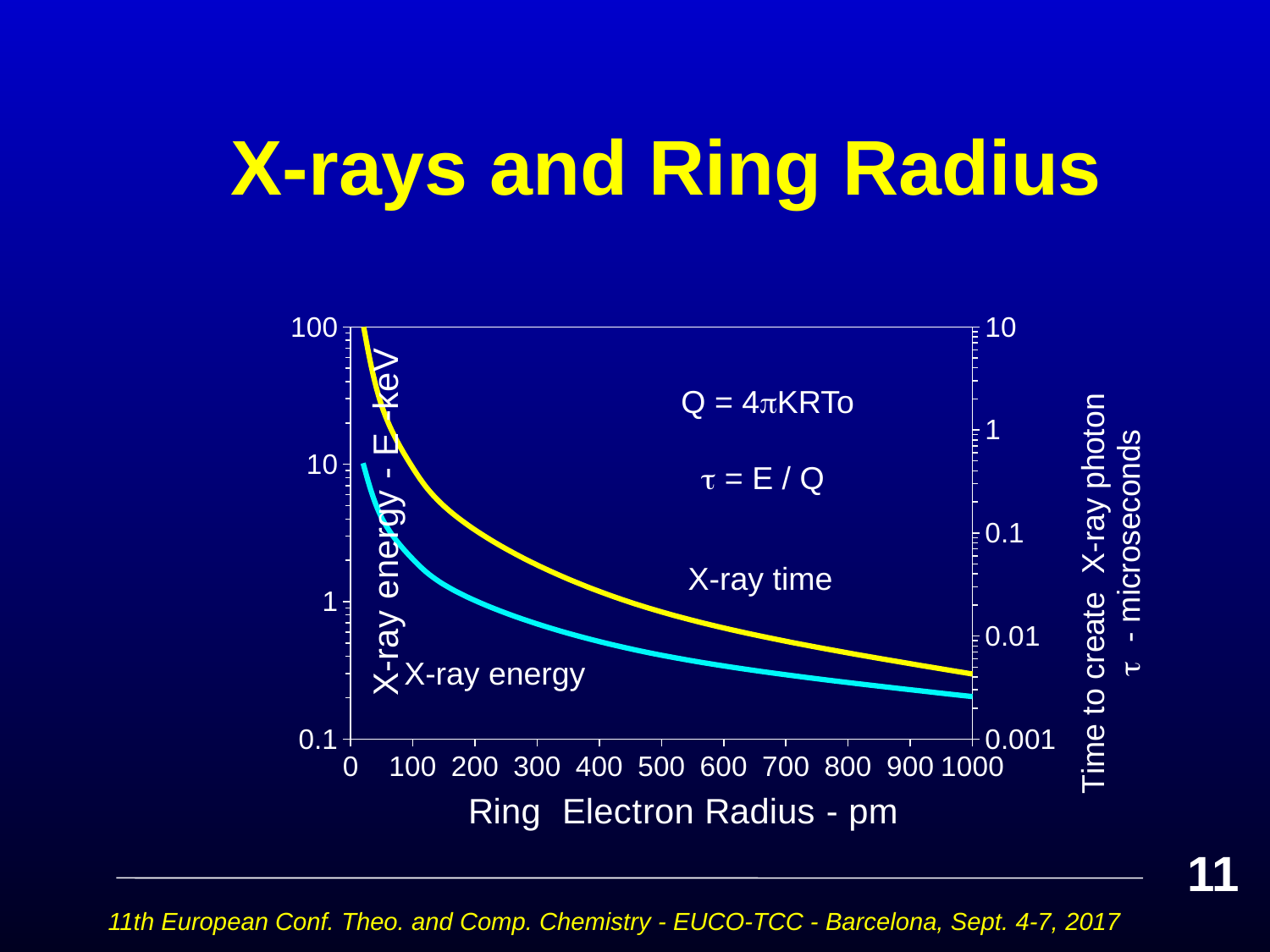
Is the X-ray time at a ring electron radius of 1000 pm greater or less than 0.01 microseconds? less What is the largest ring electron radius value shown on the x axis? 1000 Does the X-ray energy curve rise or fall as the ring electron radius increases? fall What is the highest tick value shown on the left y axis? 100 What kind of chart is shown on the slide? line chart Is the X-ray energy at a ring electron radius of 100 pm greater or less than 1 keV? greater How many curves are plotted on the chart? 2 What is the label of the x axis? Ring Electron Radius - pm Is the X-ray time at a ring electron radius of 100 pm greater or less than 0.1 microseconds? greater Does the X-ray time curve rise or fall as the ring electron radius increases? fall